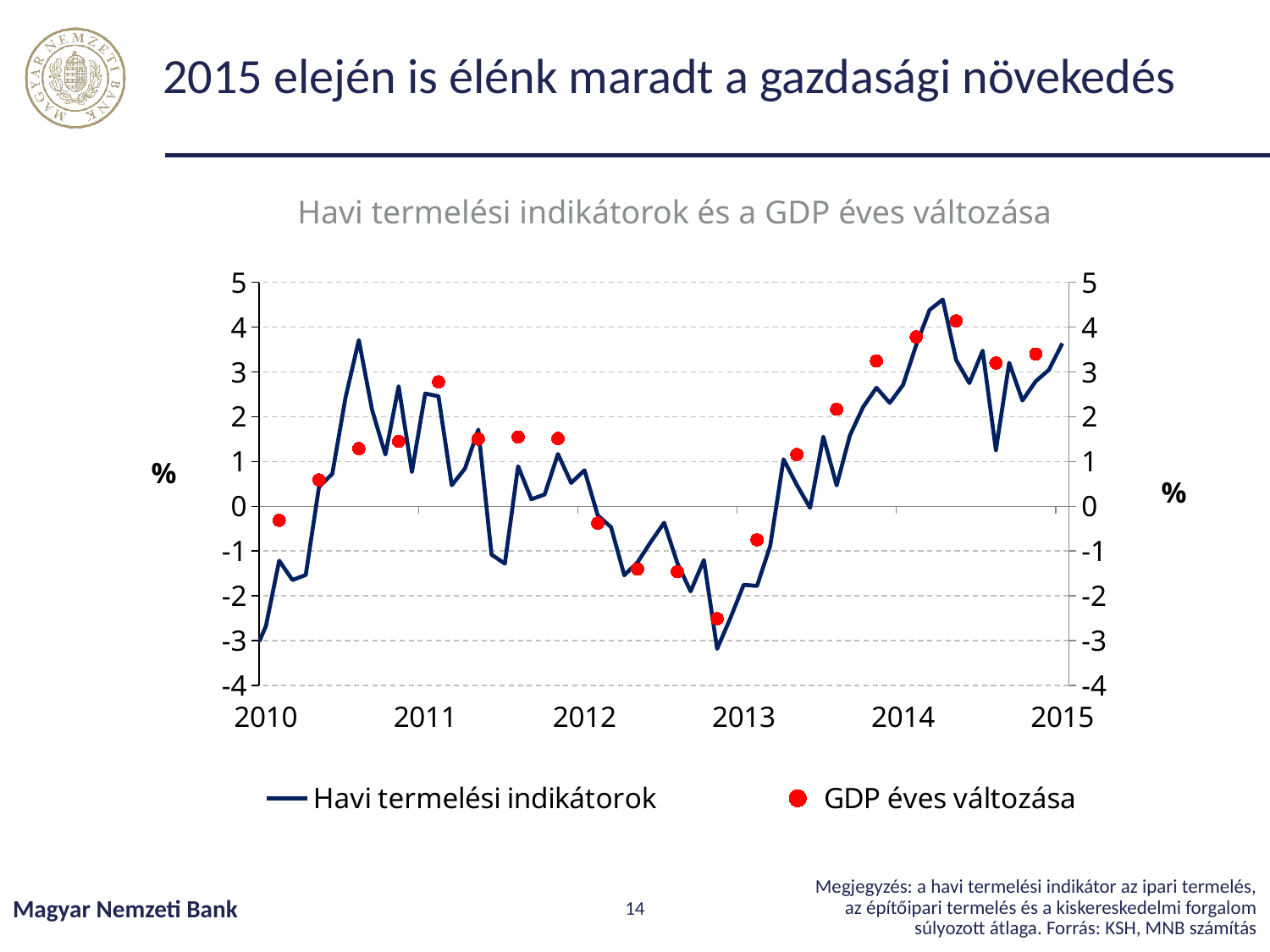
What kind of chart is shown on the slide? line chart Is the highest GDP éves változása point, located in 2014, greater or less than 4? greater Does the Havi termelési indikátorok line generally rise or fall between 2011 and the end of 2012? fall Is the lowest GDP éves változása point, located just before 2013, greater or less than -2? less Is the highest point of the Havi termelési indikátorok line, reached in 2014, greater or less than 4? greater What is the title of the chart? Havi termelési indikátorok és a GDP éves változása Does the Havi termelési indikátorok line generally rise or fall between 2013 and 2014? rise What are the two series named in the legend? Havi termelési indikátorok; GDP éves változása How many year labels are shown on the x axis? 6 How many series does the legend list? 2